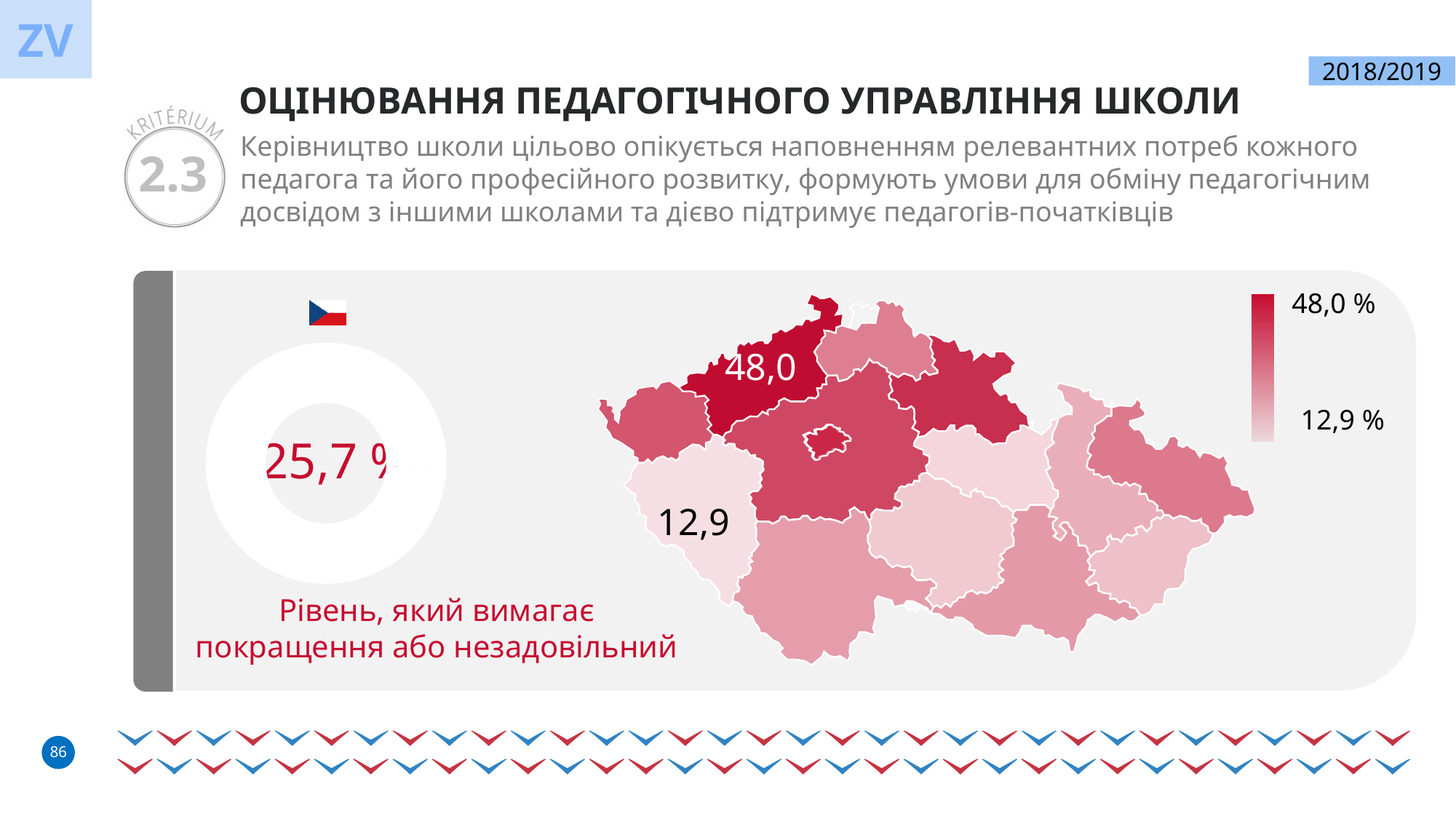
What is the minimum value shown on the colour scale legend next to the map? 12,9 % On the map of the Czech Republic, what is the lowest regional value labelled? 12,9 What kind of chart is shown on the left side of the grey panel? Donut chart What is the maximum value shown on the colour scale legend next to the map? 48,0 % On the map of the Czech Republic, what is the highest regional value labelled? 48,0 What value is shown in the centre of the donut chart on the left? 25,7 % Is the value shown in the donut chart greater or less than 20? greater Which labelled region value on the map is larger, 48,0 or 12,9? 48,0 Which region on the map is shaded the darkest red? The region labelled 48,0 What kind of chart is shown on the right side of the grey panel? Choropleth map What does the red caption below the donut chart say? Рівень, який вимагає покращення або незадовільний What is the difference between the highest (48,0) and lowest (12,9) regional values labelled on the map? 35,1